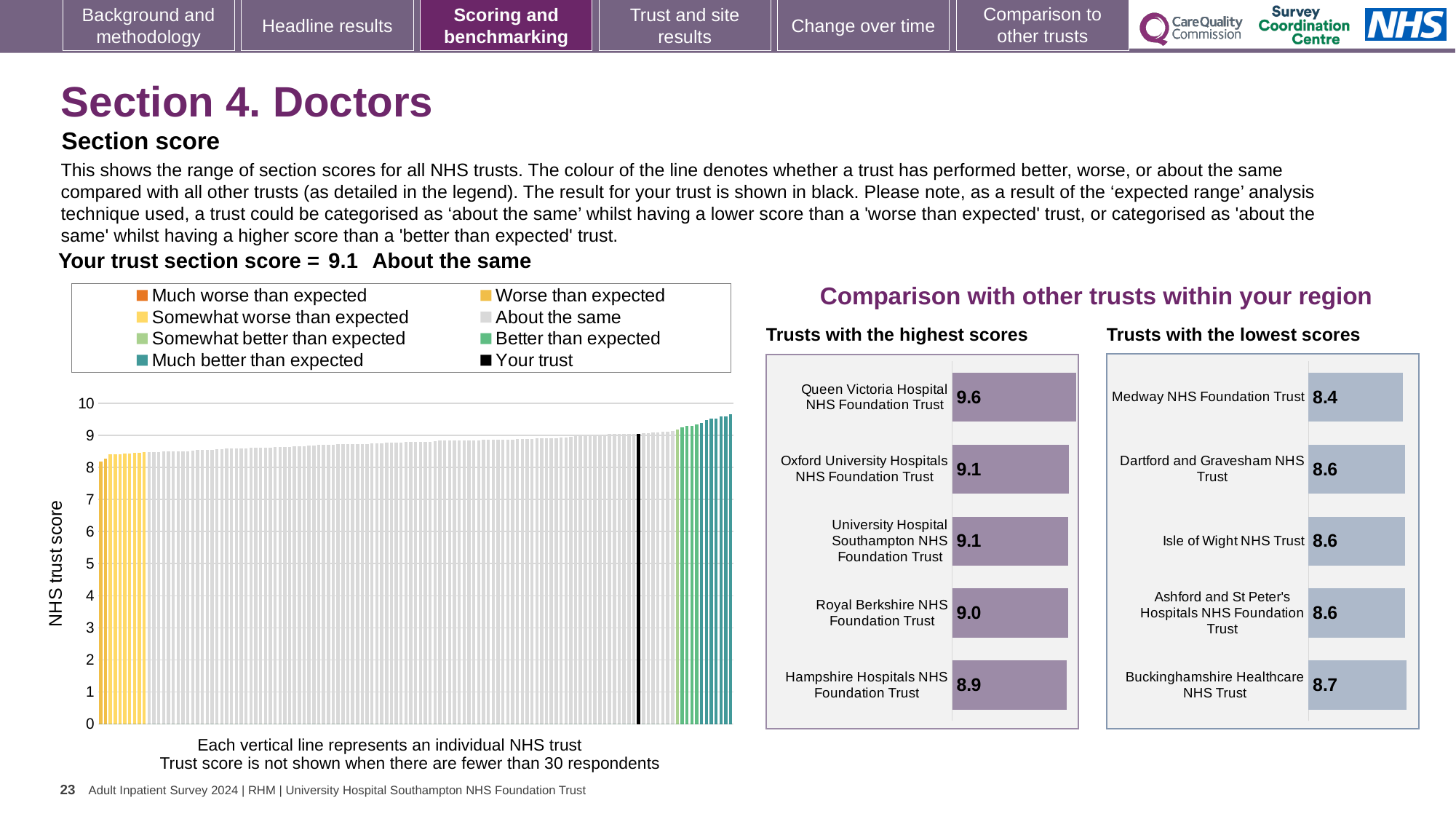
Which has the larger score: Royal Berkshire NHS Foundation Trust in the 'Trusts with the highest scores' chart or Buckinghamshire Healthcare NHS Trust in the 'Trusts with the lowest scores' chart? Royal Berkshire NHS Foundation Trust What kind of chart is the NHS trust score chart on the left of the slide? Bar chart How many entries does the legend of the NHS trust score chart on the left list? 8 In the 'Trusts with the lowest scores' chart, which trust has the lowest score? Medway NHS Foundation Trust In the 'Trusts with the highest scores' chart, which trust has the lowest score? Hampshire Hospitals NHS Foundation Trust In the 'Trusts with the lowest scores' chart, which trust has the highest score? Buckinghamshire Healthcare NHS Trust In the NHS trust score chart on the left, do the values rise or fall from left to right? Rise How many trusts are shown in the 'Trusts with the lowest scores' chart? 5 In the 'Trusts with the lowest scores' chart, what is the score for Medway NHS Foundation Trust? 8.4 In the 'Trusts with the highest scores' chart, what is the score for Queen Victoria Hospital NHS Foundation Trust? 9.6 In the 'Trusts with the highest scores' chart, what is the difference between the scores of Queen Victoria Hospital NHS Foundation Trust and Hampshire Hospitals NHS Foundation Trust? 0.7 In the 'Trusts with the highest scores' chart, which trust has the highest score? Queen Victoria Hospital NHS Foundation Trust